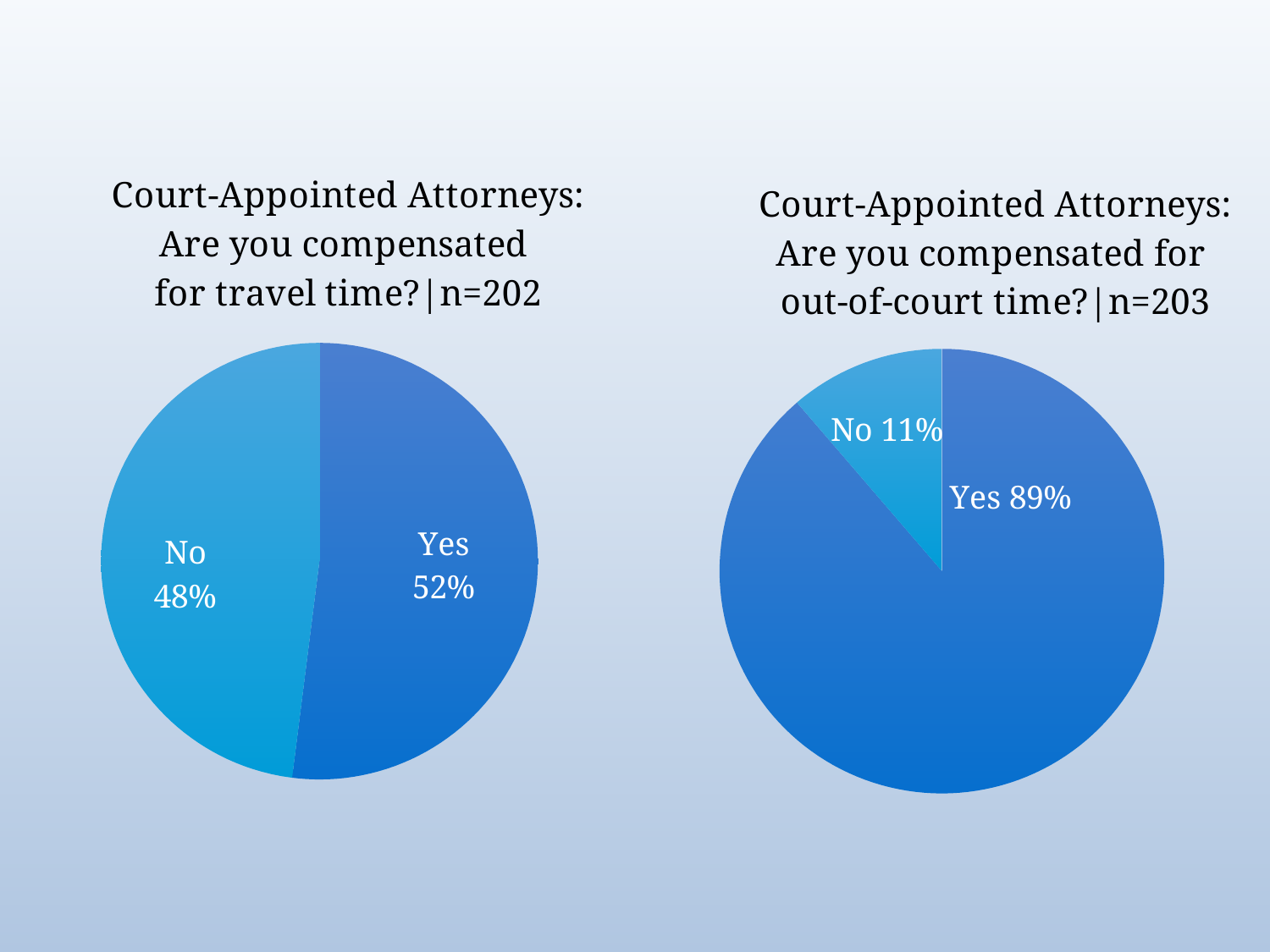
In the right chart (out-of-court time), what share of court-appointed attorneys answered Yes? 89% What is the sample size (n) shown in the title of the right chart (out-of-court time)? n=203 In the right chart (out-of-court time), which response is the smallest slice? No In the left chart (travel time), what is the difference between the Yes and No shares? 4 percentage points How many slices does the left chart (travel time) have? 2 What type of chart is used on this slide? Pie chart In the right chart (out-of-court time), what is the difference between the Yes and No shares? 78 percentage points In the left chart (travel time), what share of court-appointed attorneys answered Yes? 52% Is the Yes share larger in the left chart (travel time) or the right chart (out-of-court time)? Right chart (out-of-court time) In the left chart (travel time), what share of court-appointed attorneys answered No? 48% In the right chart (out-of-court time), which response is the largest slice? Yes In the right chart (out-of-court time), what share of court-appointed attorneys answered No? 11%